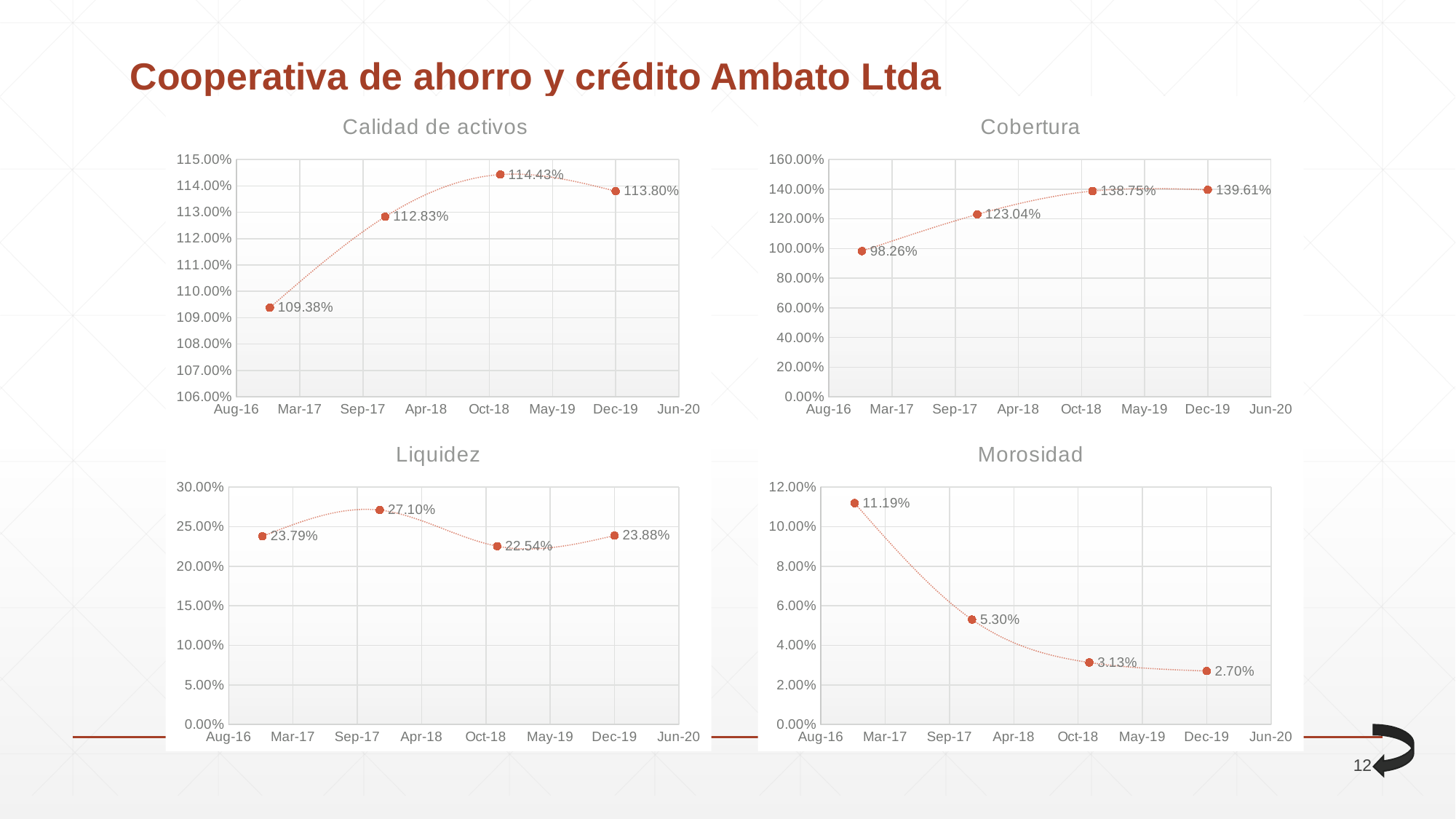
In the Cobertura chart, what is the value of the last (latest) data point? 139.61% In the Morosidad chart, what is the difference between the first and last data points? 8.49% How many data points are plotted in the Liquidez chart? 4 In the Calidad de activos chart, which data point has the highest value? 114.43% In the Cobertura chart, what is the difference between the highest and lowest values? 41.35% In the Cobertura chart, is the first data point greater or less than 100.00%? less In the Liquidez chart, what is the lowest value? 22.54% What kind of chart is the Cobertura chart? line chart In the Calidad de activos chart, what is the value of the first (earliest) data point? 109.38% In the Liquidez chart, what is the value of the second data point? 27.10% In the Morosidad chart, which is larger, the second data point or the third data point? the second (5.30%) In the Morosidad chart, do the values rise or fall over time? fall